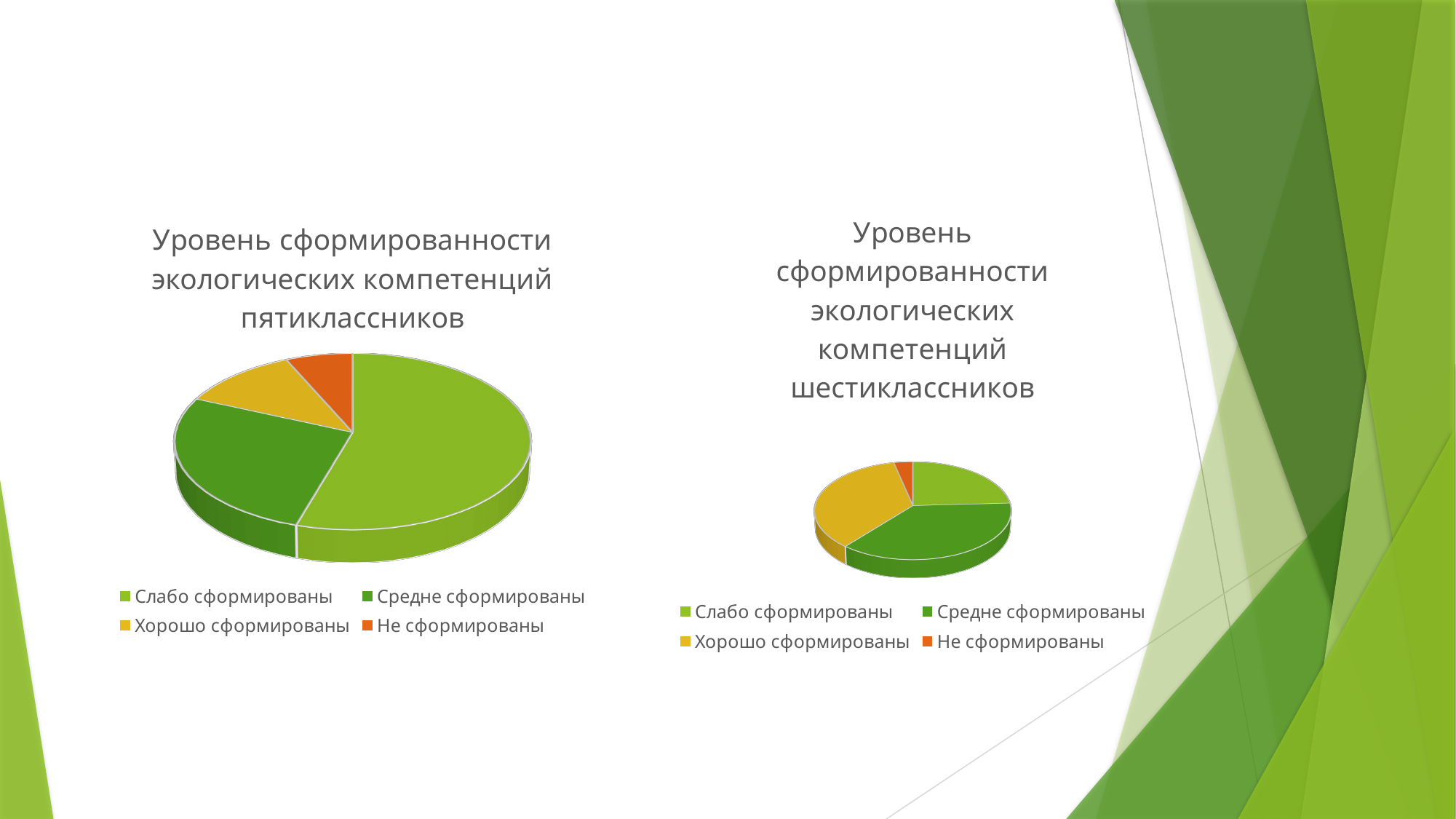
In the right chart (шестиклассников), how many entries does the legend list? 4 What kind of chart is the left chart, titled "Уровень сформированности экологических компетенций пятиклассников"? pie chart In the left chart (пятиклассников), how many slices does the pie have? 4 What is the title of the left chart? Уровень сформированности экологических компетенций пятиклассников In the right chart (шестиклассников), which slice is larger: "Хорошо сформированы" or "Не сформированы"? Хорошо сформированы In the right chart (шестиклассников), which legend entry is shown in orange? Не сформированы In the left chart (пятиклассников), which category has the largest slice? Слабо сформированы In the left chart (пятиклассников), which category has the smallest slice? Не сформированы In the left chart (пятиклассников), which slice is larger: "Средне сформированы" or "Хорошо сформированы"? Средне сформированы What kind of chart is the right chart, titled "Уровень сформированности экологических компетенций шестиклассников"? pie chart In the right chart (шестиклассников), which category has the smallest slice? Не сформированы